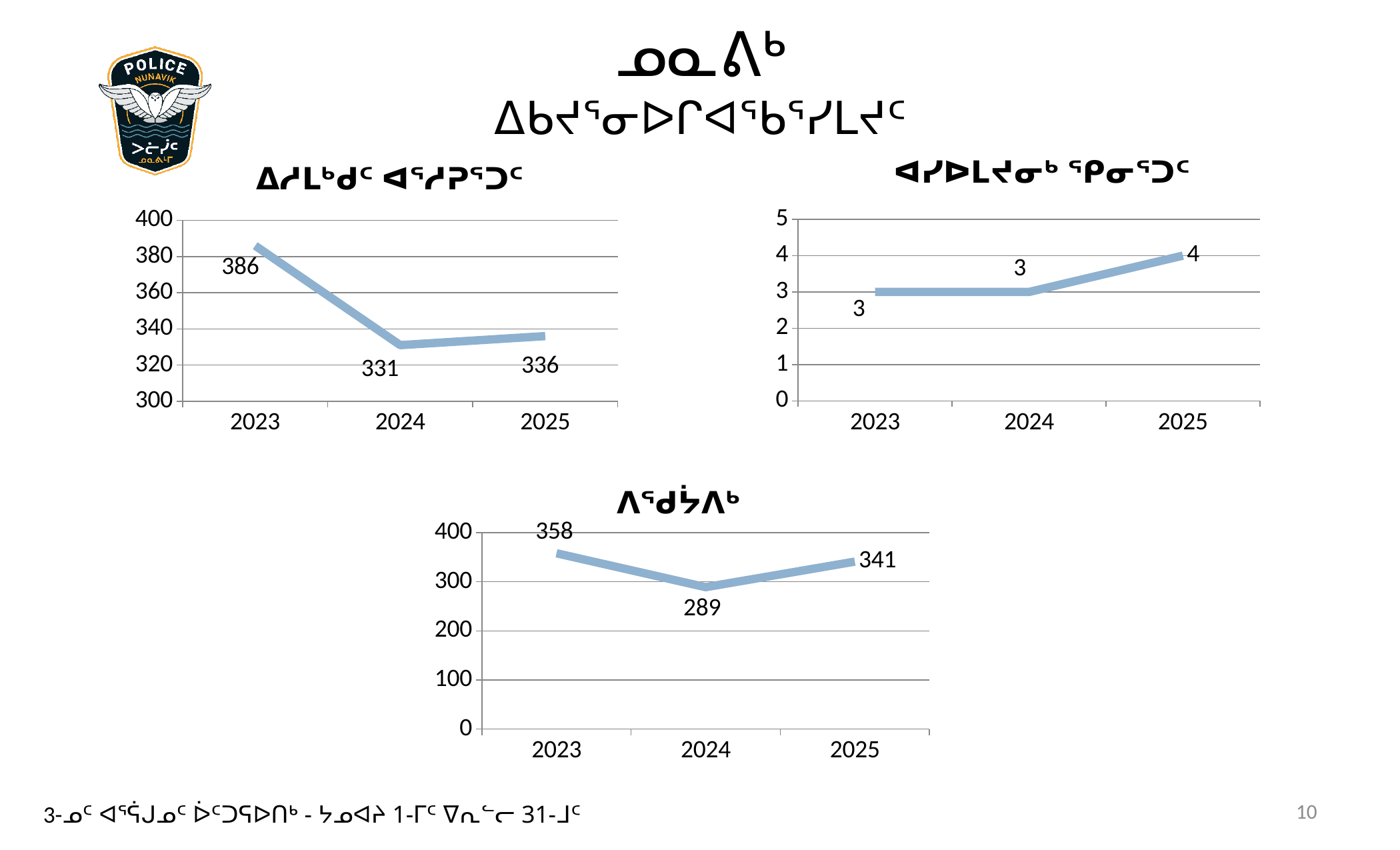
In the bottom chart, what is the value for 2024? 289 In the top-right chart, which year has the highest value? 2025 In the top-left chart, what is the value for 2023? 386 In the top-left chart, which year has the highest value? 2023 In the bottom chart, is the value for 2023 or 2025 larger? 2023 In the top-left chart, what is the value for 2024? 331 In the top-left chart, what is the difference between the 2023 and 2024 values? 55 In the bottom chart, which year has the lowest value? 2024 In the bottom chart, what is the difference between the 2023 and 2025 values? 17 What kind of chart is the bottom chart? Line chart In the top-right chart, how many years are plotted on the x axis? 3 In the top-right chart, what is the value for 2025? 4